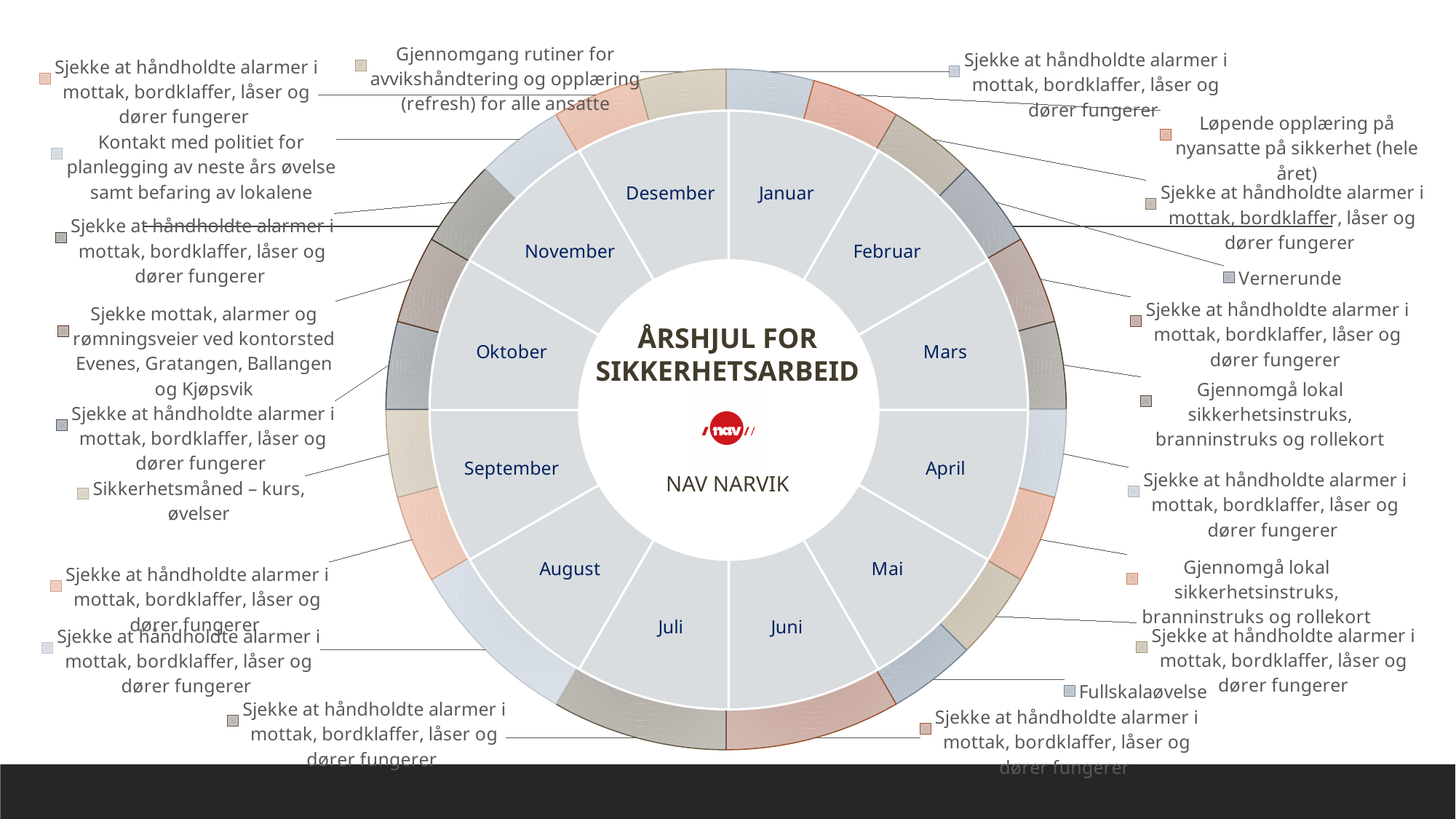
What is the title printed in the centre of the wheel chart? ÅRSHJUL FOR SIKKERHETSARBEID Which month segment is at the bottom of the wheel next to Juli? Juni How many month segments does the wheel chart contain? 12 What kind of chart is shown on the slide? Doughnut chart Which month segment is labelled directly below Oktober on the left side of the wheel? September Which month segment is directly to the left of Januar at the top of the wheel? Desember Which month segment lies between Januar and Mars on the wheel? Februar Which organisation name is printed below the logo in the centre of the wheel? NAV NARVIK